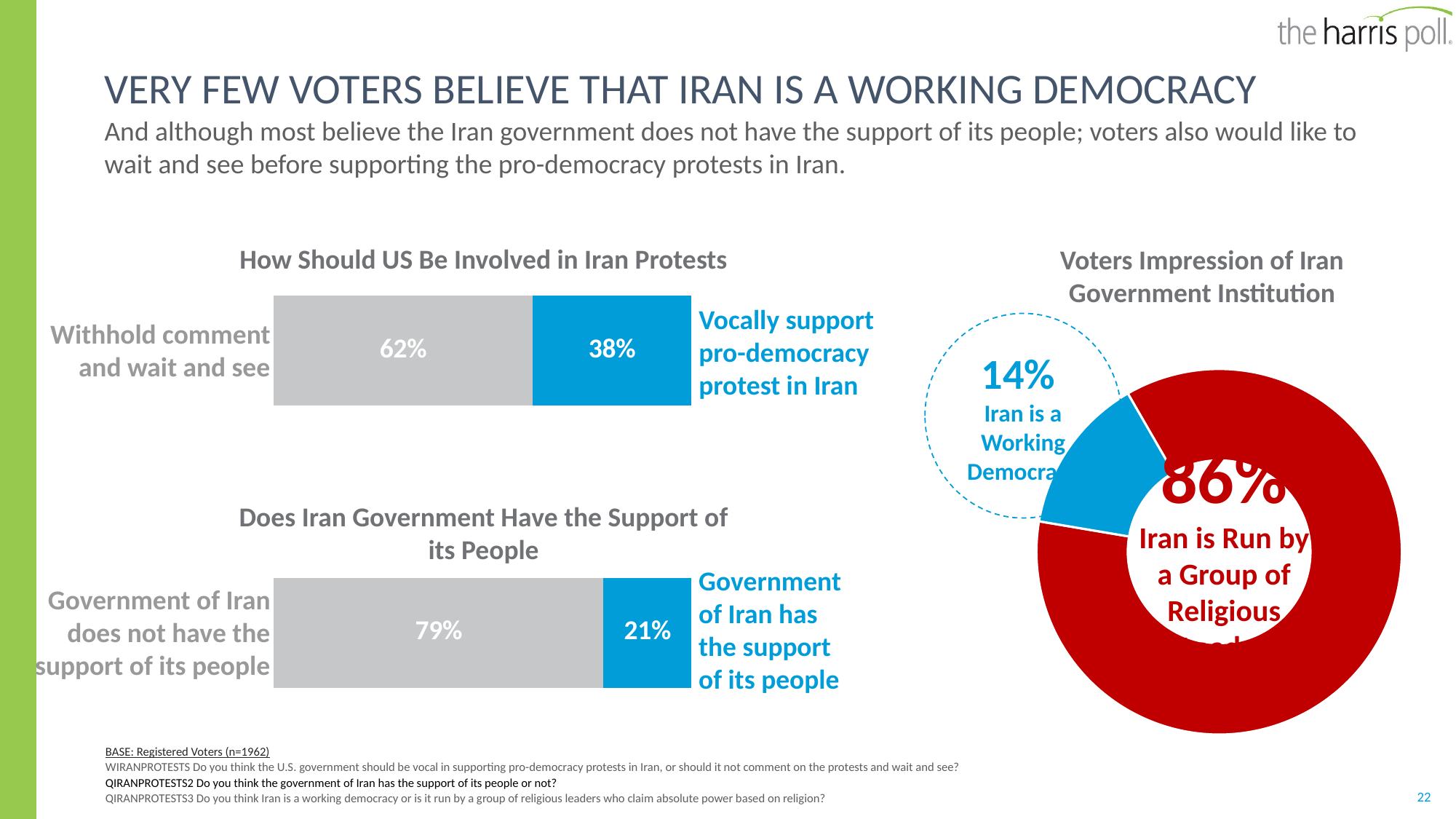
What type of chart is 'Voters Impression of Iran Government Institution'? Donut chart In the chart 'How Should US Be Involved in Iran Protests', what is the difference between the share who would withhold comment and the share who would vocally support the protests? 24% In the chart 'Voters Impression of Iran Government Institution', what percentage of voters believe Iran is a working democracy? 14% What type of chart is 'How Should US Be Involved in Iran Protests'? Bar chart In the chart 'How Should US Be Involved in Iran Protests', what percentage of voters say the US should vocally support the pro-democracy protest in Iran? 38% In the chart 'How Should US Be Involved in Iran Protests', what percentage of voters say the US should withhold comment and wait and see? 62% In the chart 'Does Iran Government Have the Support of its People', what percentage say the government of Iran has the support of its people? 21% In the chart 'Does Iran Government Have the Support of its People', what is the difference between the two response percentages? 58% In the chart 'Does Iran Government Have the Support of its People', what percentage say the government of Iran does not have the support of its people? 79% In the chart 'Voters Impression of Iran Government Institution', what percentage of voters believe Iran is run by a group of religious leaders? 86% In the chart 'How Should US Be Involved in Iran Protests', what colour is the segment for 'Vocally support pro-democracy protest in Iran'? Blue In the chart 'Does Iran Government Have the Support of its People', which response is larger: 'does not have the support' or 'has the support'? Government of Iran does not have the support of its people